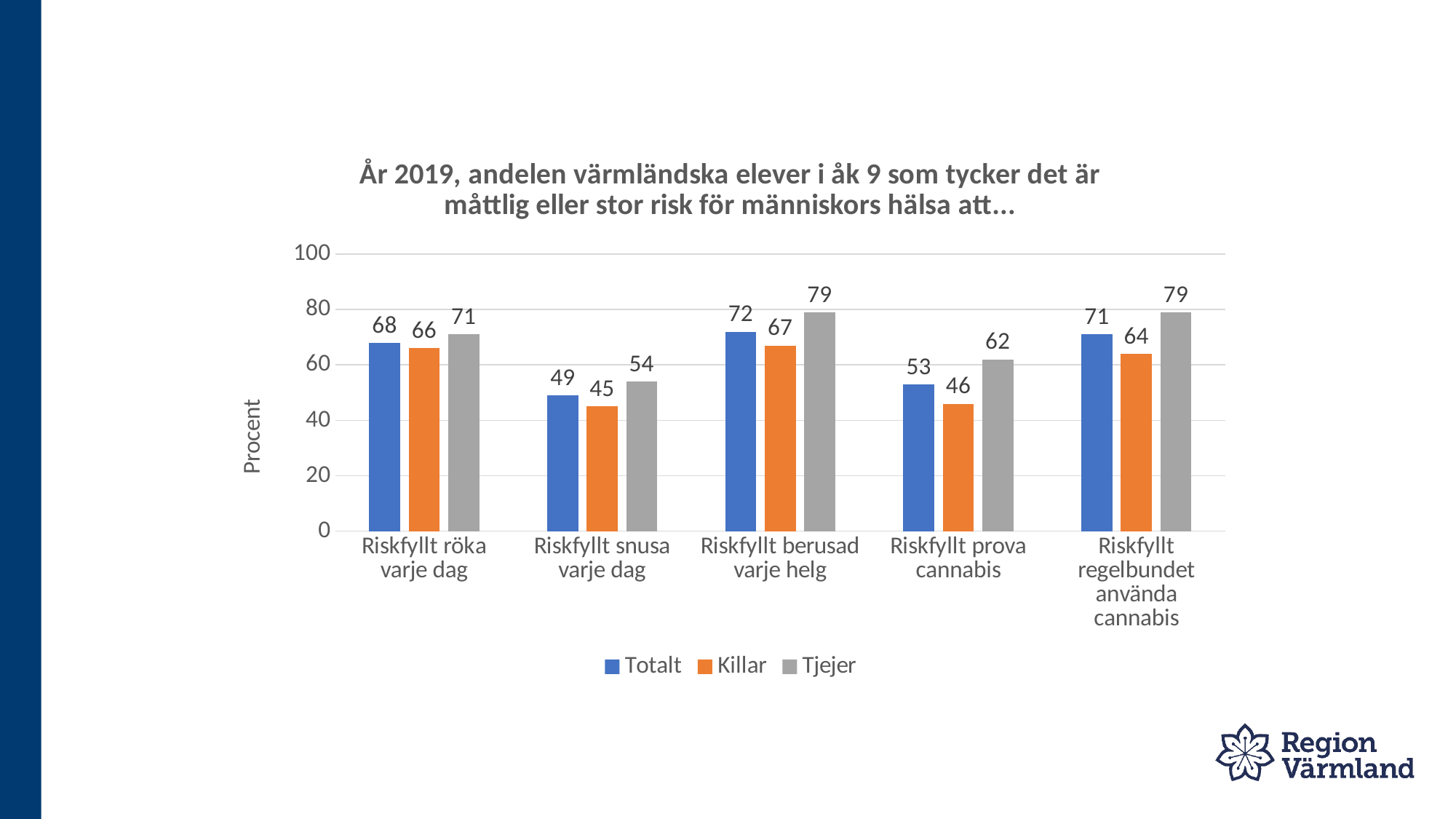
Which category has the highest Killar value? Riskfyllt berusad varje helg What is the value for Killar in the category 'Riskfyllt snusa varje dag'? 45 What is the Totalt value for 'Riskfyllt prova cannabis'? 53 What is the difference between the Tjejer and Killar values for 'Riskfyllt regelbundet använda cannabis'? 15 Which category has the lowest Totalt value? Riskfyllt snusa varje dag What is the label of the y axis? Procent Which is larger for 'Riskfyllt röka varje dag': the Totalt value or the Tjejer value? Tjejer Is the Killar value for 'Riskfyllt prova cannabis' greater or less than 60? less How many series does the legend list? 3 What kind of chart is shown on the slide? bar chart What is the value for Tjejer in the category 'Riskfyllt berusad varje helg'? 79 How many categories are shown on the x axis? 5